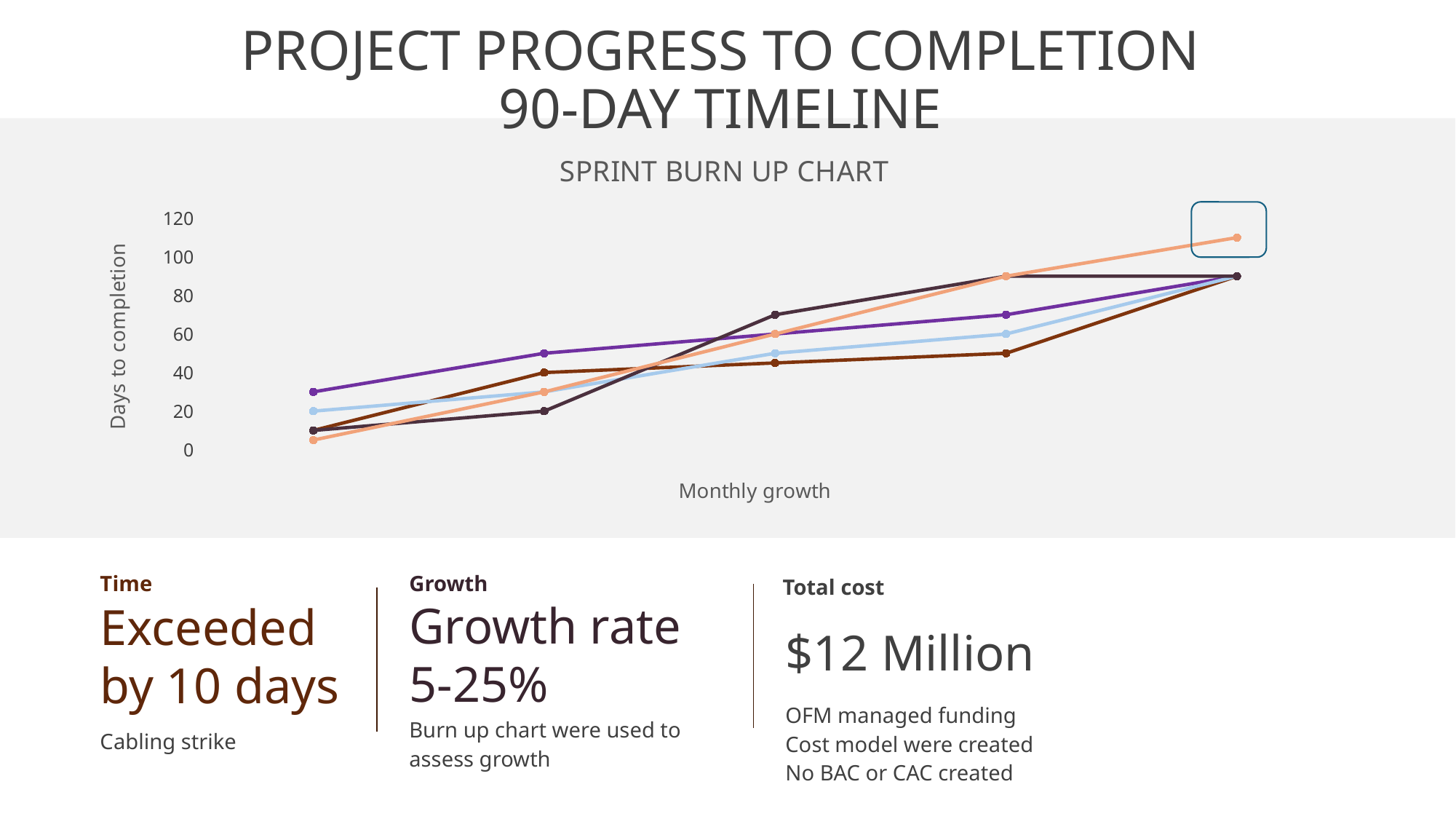
Is the final value of the orange line greater or less than 100? greater What is the title of the chart? SPRINT BURN UP CHART Is the final value of the purple line greater or less than 100? less What is the value of the first point on the light blue line? 20 Do the lines on the chart generally rise or fall from left to right? Rise What is the highest tick value shown on the vertical axis? 120 How many data points does each line on the chart have? 5 Which line reaches the highest value at the final point on the chart? The orange line How many lines are plotted on the chart? 5 What is the label on the vertical axis of the chart? Days to completion What kind of chart is shown on the slide? Line chart Is the first value of the orange line greater or less than 20? less